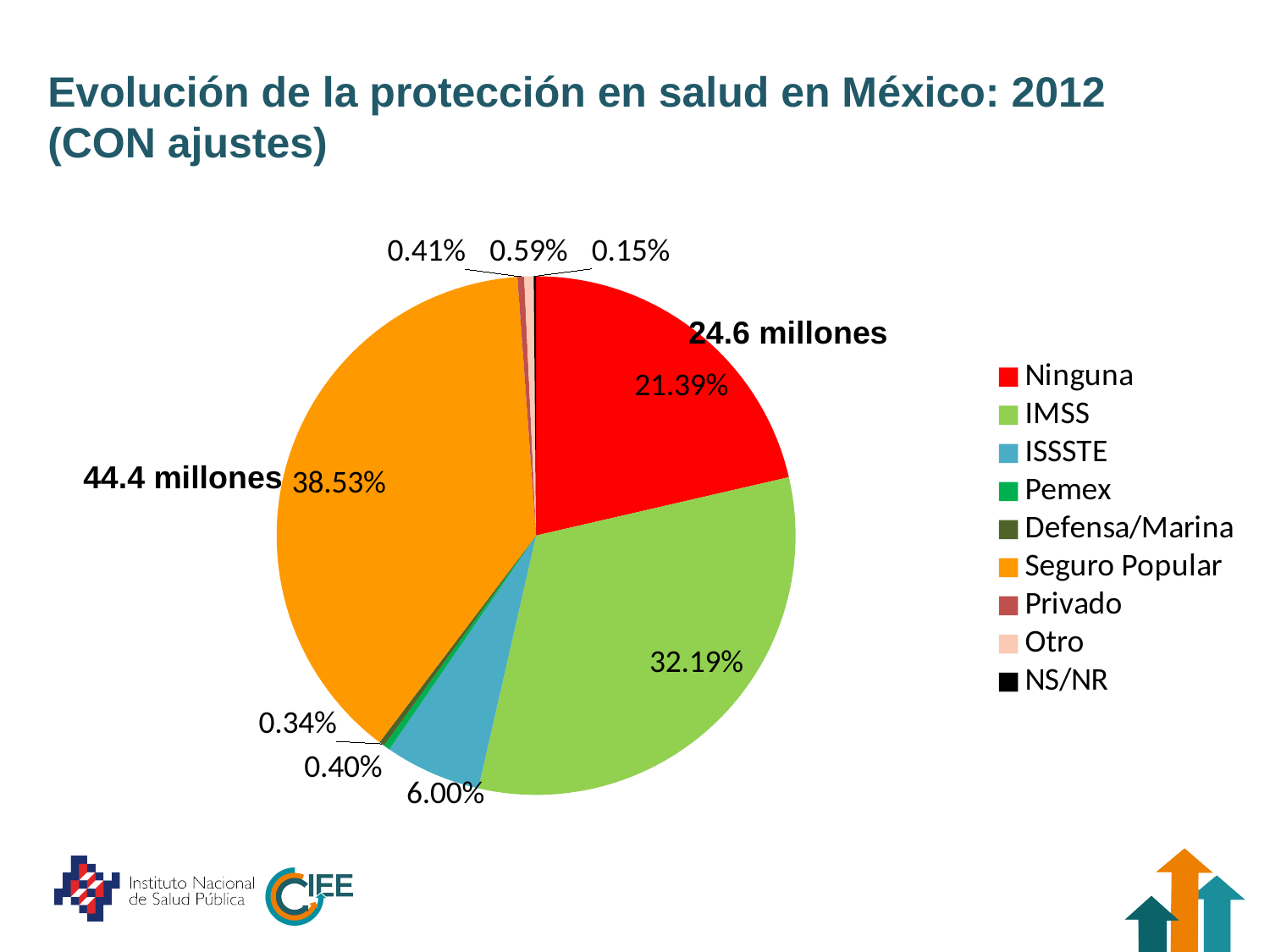
What is the value shown for Ninguna? 21.39% Which category has the smallest slice of the pie? NS/NR What kind of chart is shown on the slide? pie chart Which category has the largest slice of the pie? Seguro Popular What is the value shown for IMSS? 32.19% How many categories does the legend list? 9 What is the value shown for ISSSTE? 6.00% How many millions of people are annotated next to the Seguro Popular slice? 44.4 millones Which is larger, the share for Ninguna or the share for IMSS? IMSS What colour is the Ninguna slice? red What share of the pie does Seguro Popular hold? 38.53% What is the difference between the Seguro Popular share and the IMSS share? 6.34%